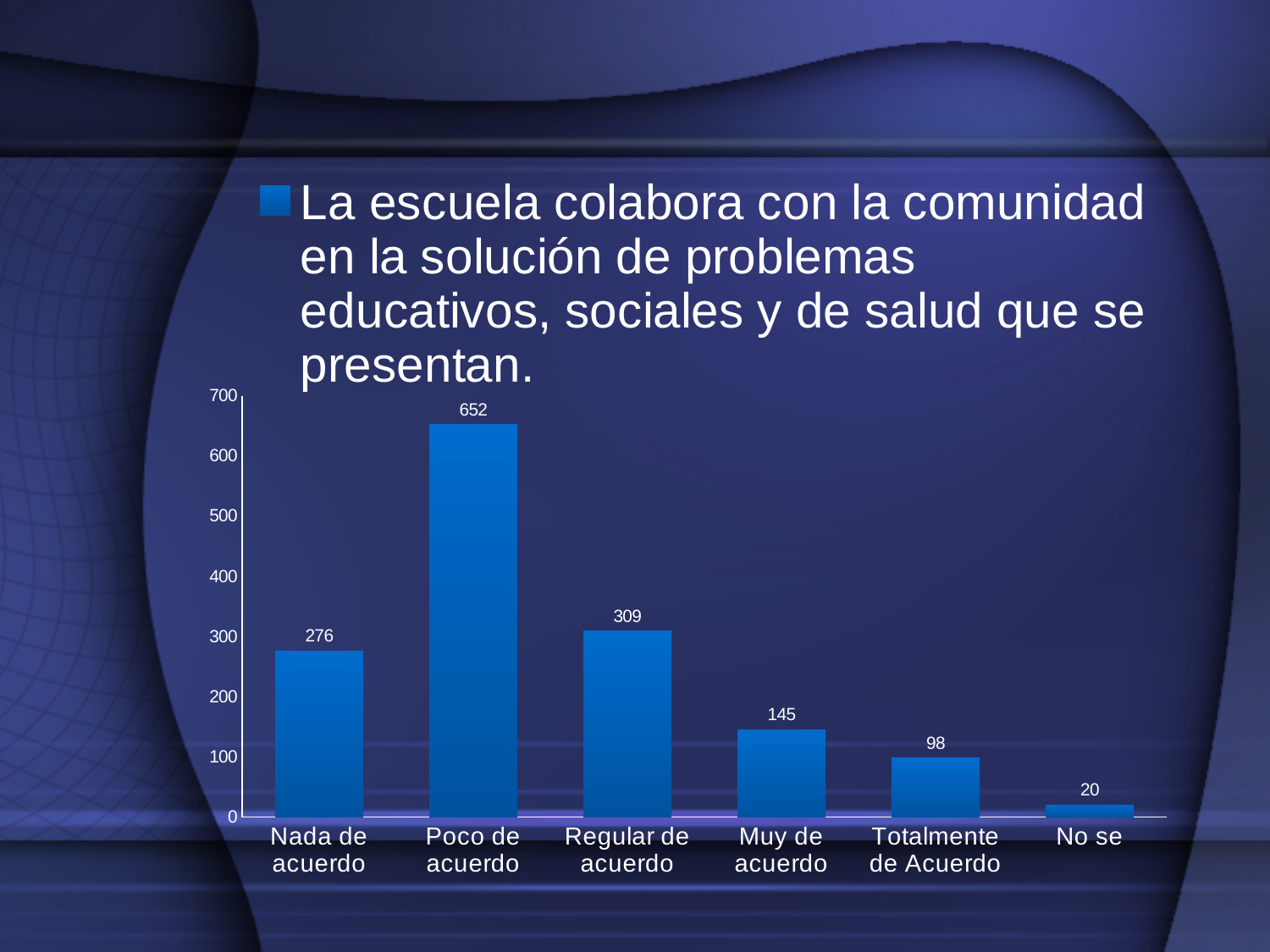
What is the maximum value shown on the vertical axis? 700 What kind of chart is shown on the slide? bar chart Which is larger, the value for "Nada de acuerdo" or the value for "Regular de acuerdo"? Regular de acuerdo What is the value for "Nada de acuerdo"? 276 Which category has the lowest value? No se What is the difference between the values for "Poco de acuerdo" and "Regular de acuerdo"? 343 What is the value for "Totalmente de Acuerdo"? 98 What is the value for "Poco de acuerdo"? 652 Which category has the highest value? Poco de acuerdo Is the value for "Muy de acuerdo" greater or less than 200? less What is the value for "No se"? 20 How many categories are shown on the x axis? 6